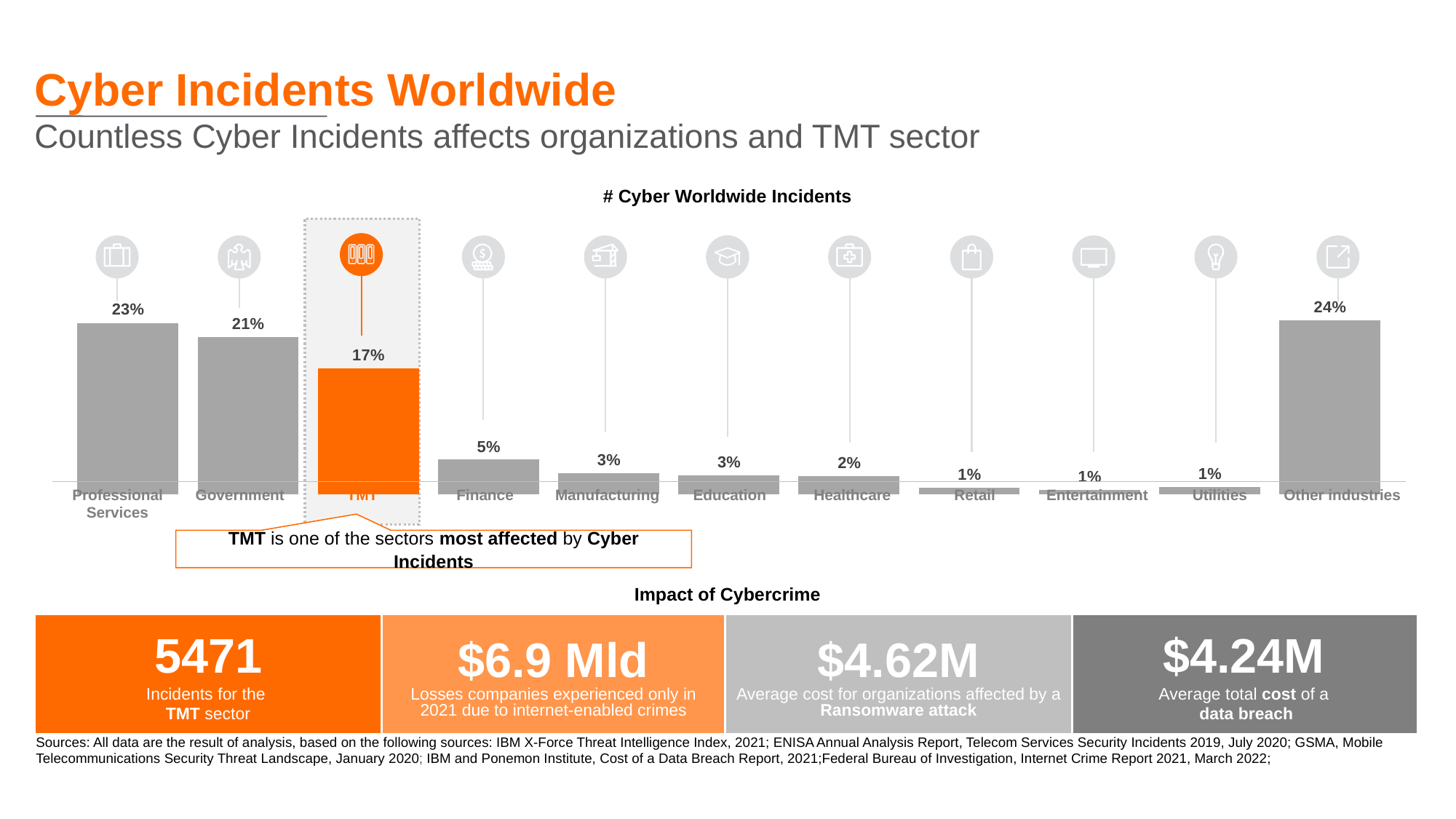
What is the value for Government in the # Cyber Worldwide Incidents chart? 21% Which is larger in the # Cyber Worldwide Incidents chart, the value for Government or the value for Finance? Government What is the value for Finance in the # Cyber Worldwide Incidents chart? 5% Which category has the highest value in the # Cyber Worldwide Incidents chart? Other industries What is the difference between the values for Professional Services and TMT in the # Cyber Worldwide Incidents chart? 6 percentage points Which category's bar is highlighted in orange in the # Cyber Worldwide Incidents chart? TMT What is the value for Healthcare in the # Cyber Worldwide Incidents chart? 2% What kind of chart is the # Cyber Worldwide Incidents chart? Bar chart How many categories are shown in the # Cyber Worldwide Incidents chart? 11 What is the value for TMT in the # Cyber Worldwide Incidents chart? 17% What is the difference between the values for Government and Finance in the # Cyber Worldwide Incidents chart? 16 percentage points What is the value for Professional Services in the # Cyber Worldwide Incidents chart? 23%